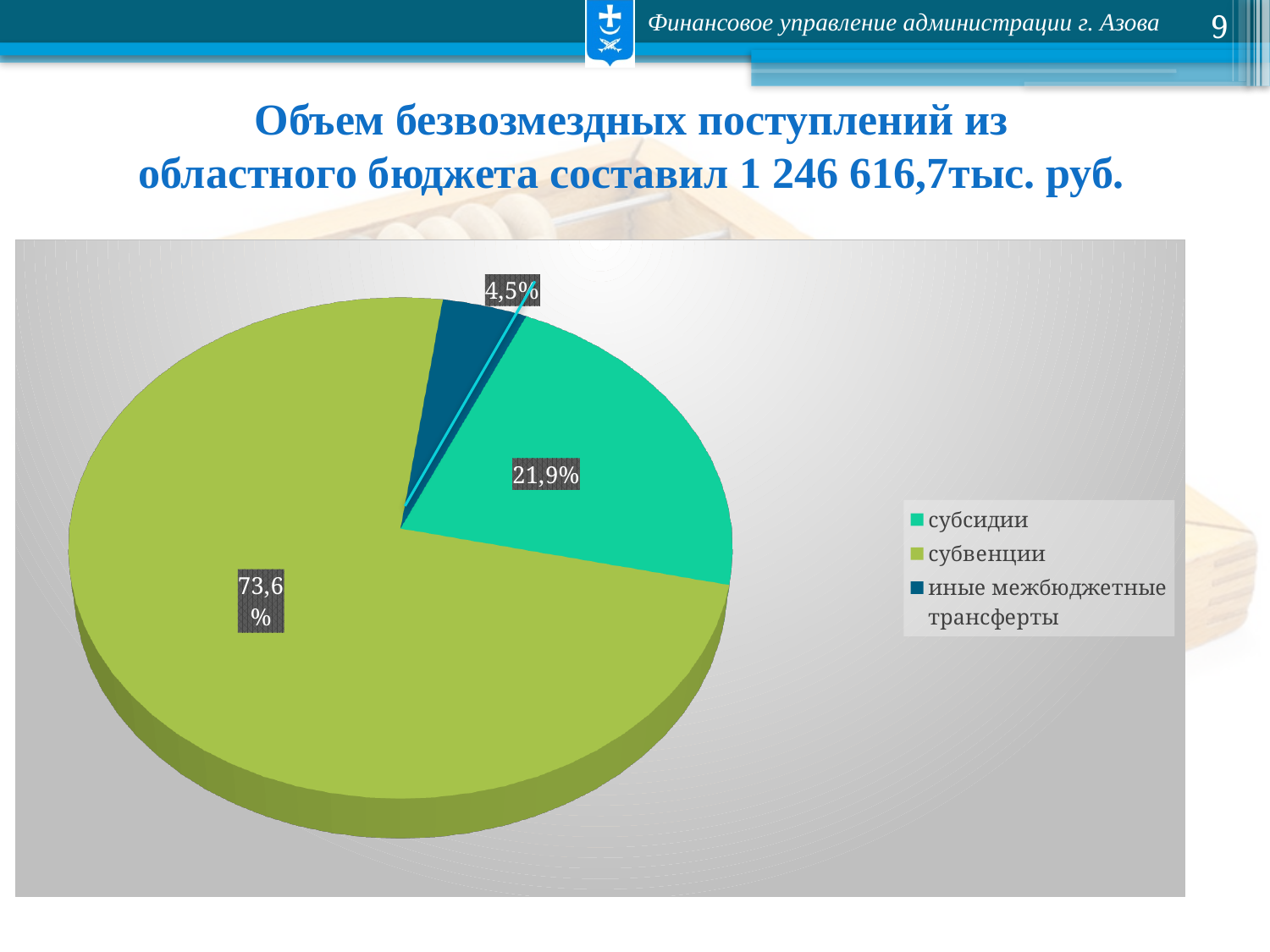
What share of the pie does субвенции account for? 73,6% What colour is the slice for субвенции? green How many slices does the pie chart have? 3 What share of the pie does субсидии account for? 21,9% Which category has the smallest slice of the pie? иные межбюджетные трансферты Which category has the largest slice of the pie? субвенции What is the difference in percentage points between субсидии and иные межбюджетные трансферты? 17,4 What share of the pie does иные межбюджетные трансферты account for? 4,5% Which is larger, the share for субсидии or the share for иные межбюджетные трансферты? субсидии What kind of chart is shown on the slide? pie chart How many entries does the legend list? 3 What is the difference in percentage points between субвенции and субсидии? 51,7